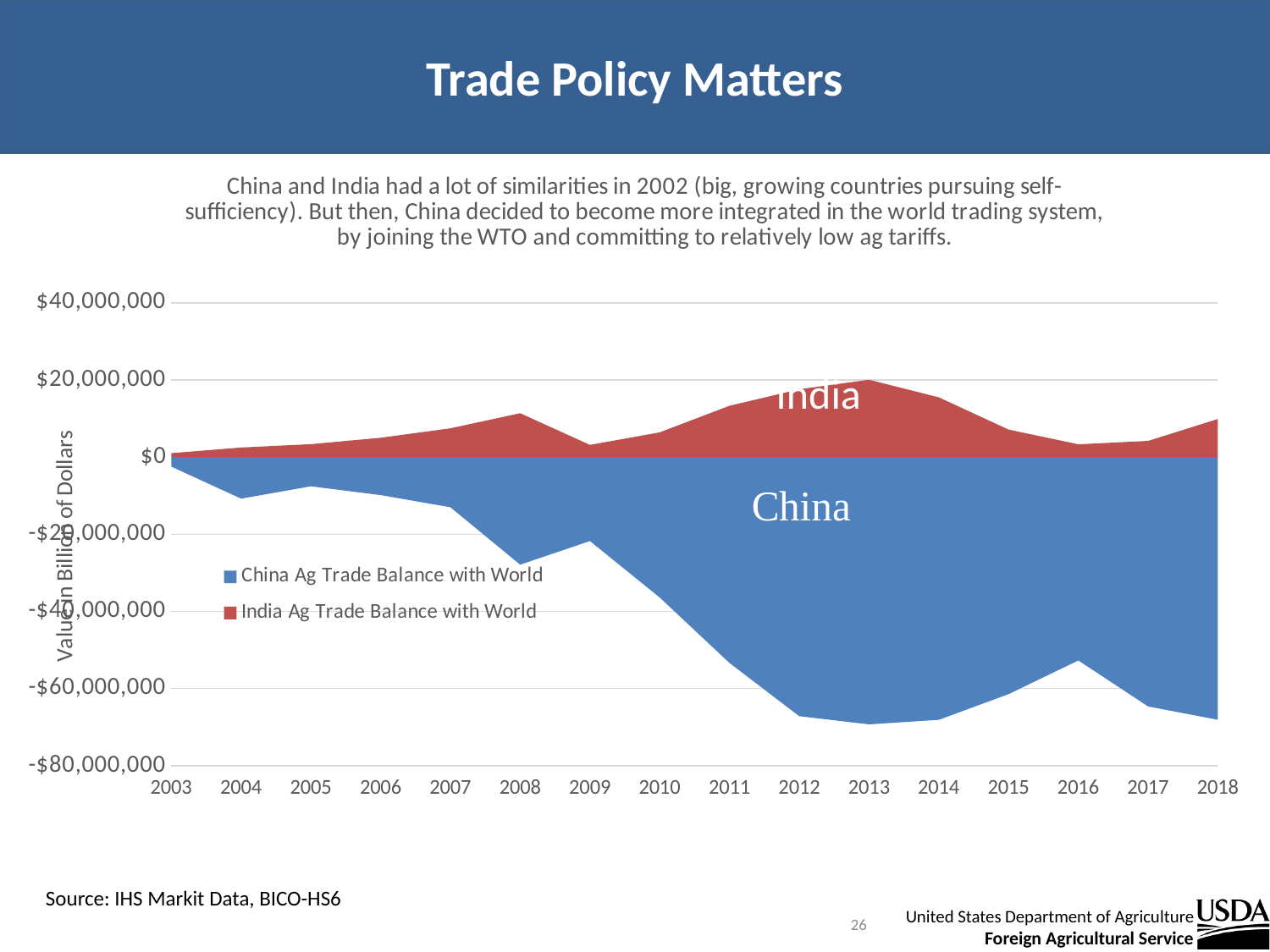
Which is larger, the India Ag Trade Balance with World in 2013 or in 2003? 2013 How many series does the legend list? 2 Which year has the highest value for India Ag Trade Balance with World? 2013 Is the value for China Ag Trade Balance with World in 2013 greater or less than -$60,000,000? less What colour represents India Ag Trade Balance with World in the chart? red Does the China Ag Trade Balance with World rise or fall from 2003 to 2013? fall Is the value for China Ag Trade Balance with World in 2003 greater or less than -$20,000,000? greater Is the value for China Ag Trade Balance with World in 2016 greater or less than -$60,000,000? greater How many years are shown along the x axis? 16 Which is larger, the China Ag Trade Balance with World in 2003 or in 2013? 2003 What kind of chart is shown on the slide? area chart